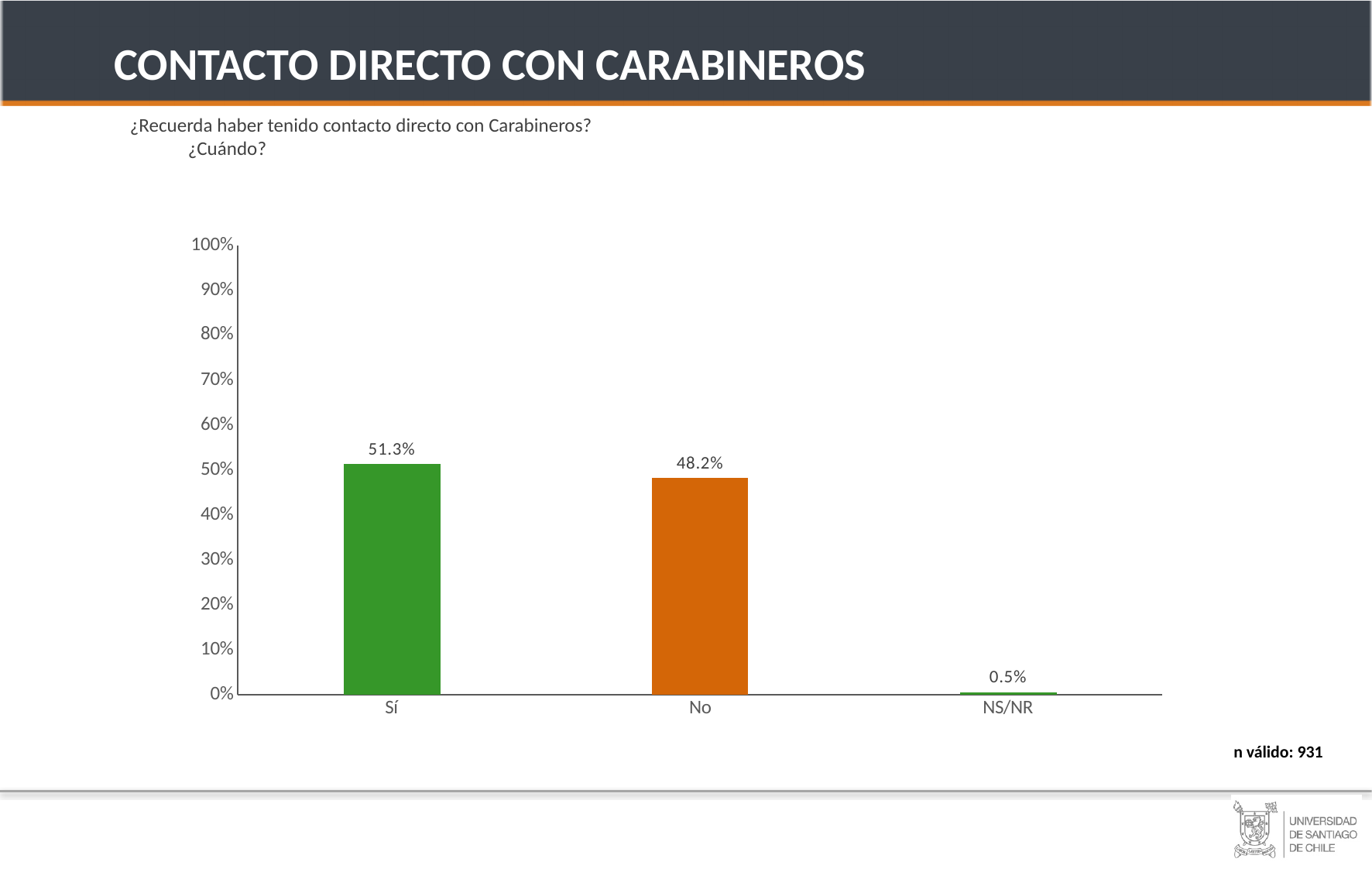
What is the value for No? 48.2% How many categories are shown on the x axis? 3 What is the difference between the values for Sí and No? 3.1% Which category has the lowest value? NS/NR Which category has the highest value? Sí What is the value for Sí? 51.3% Which is larger, the value for Sí or the value for No? Sí What is the value for NS/NR? 0.5% What kind of chart is shown on the slide? bar chart What colour is the bar for No? orange Is the value for No greater or less than 50%? less What is the difference between the values for No and NS/NR? 47.7%